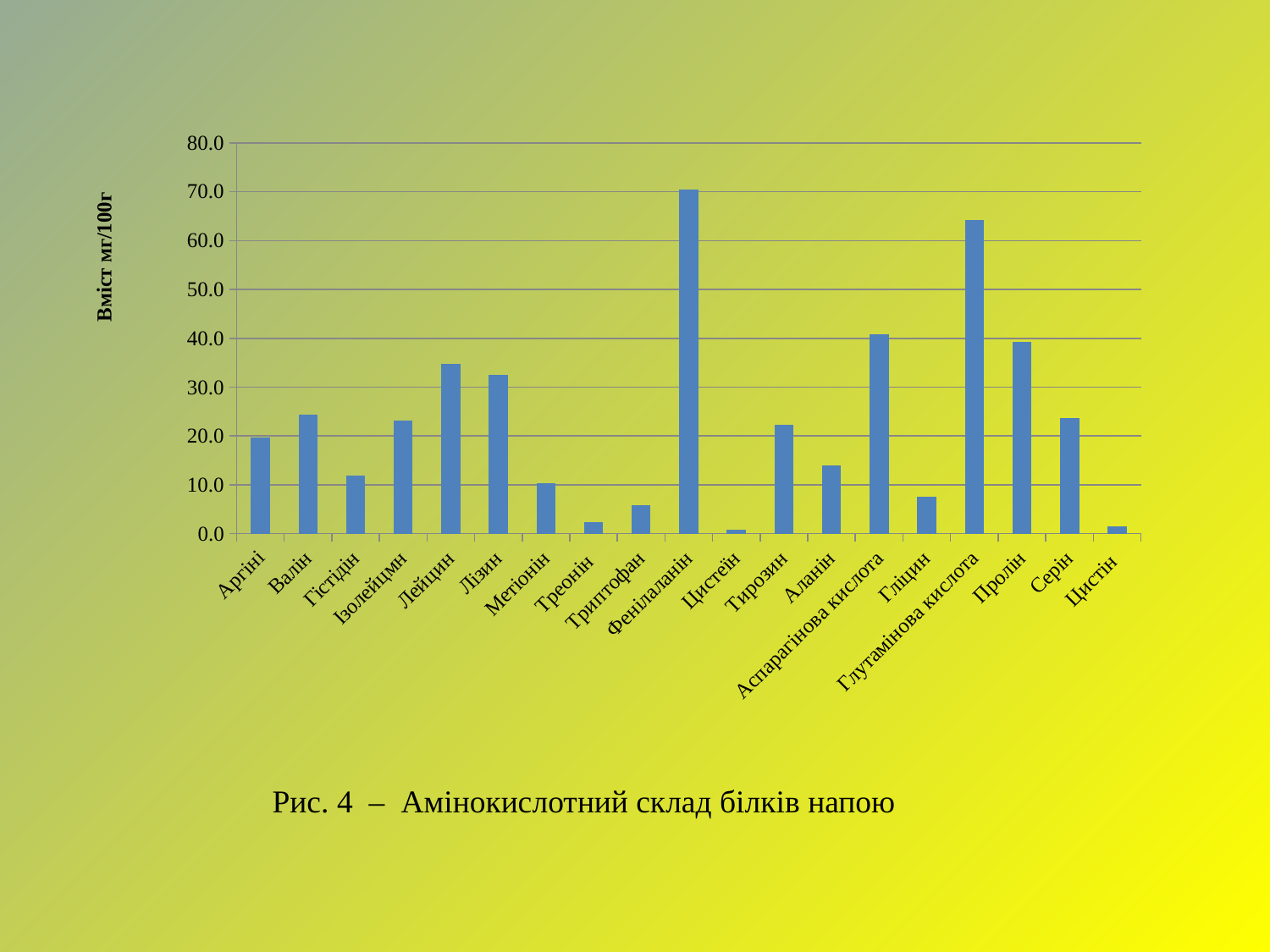
Is the value for Глутамінова кислота greater or less than 60.0? greater What is the label of the vertical axis? Вміст мг/100г Which is larger, the value for Фенілаланін or the value for Глутамінова кислота? Фенілаланін Is the value for Лейцин greater or less than 30.0? greater Is the value for Гліцин greater or less than 10.0? less What kind of chart is shown on the slide? bar chart Which is larger, the value for Валін or the value for Гістідін? Валін Which amino acid has the highest value in the chart? Фенілаланін How many amino acid categories are plotted on the x axis? 19